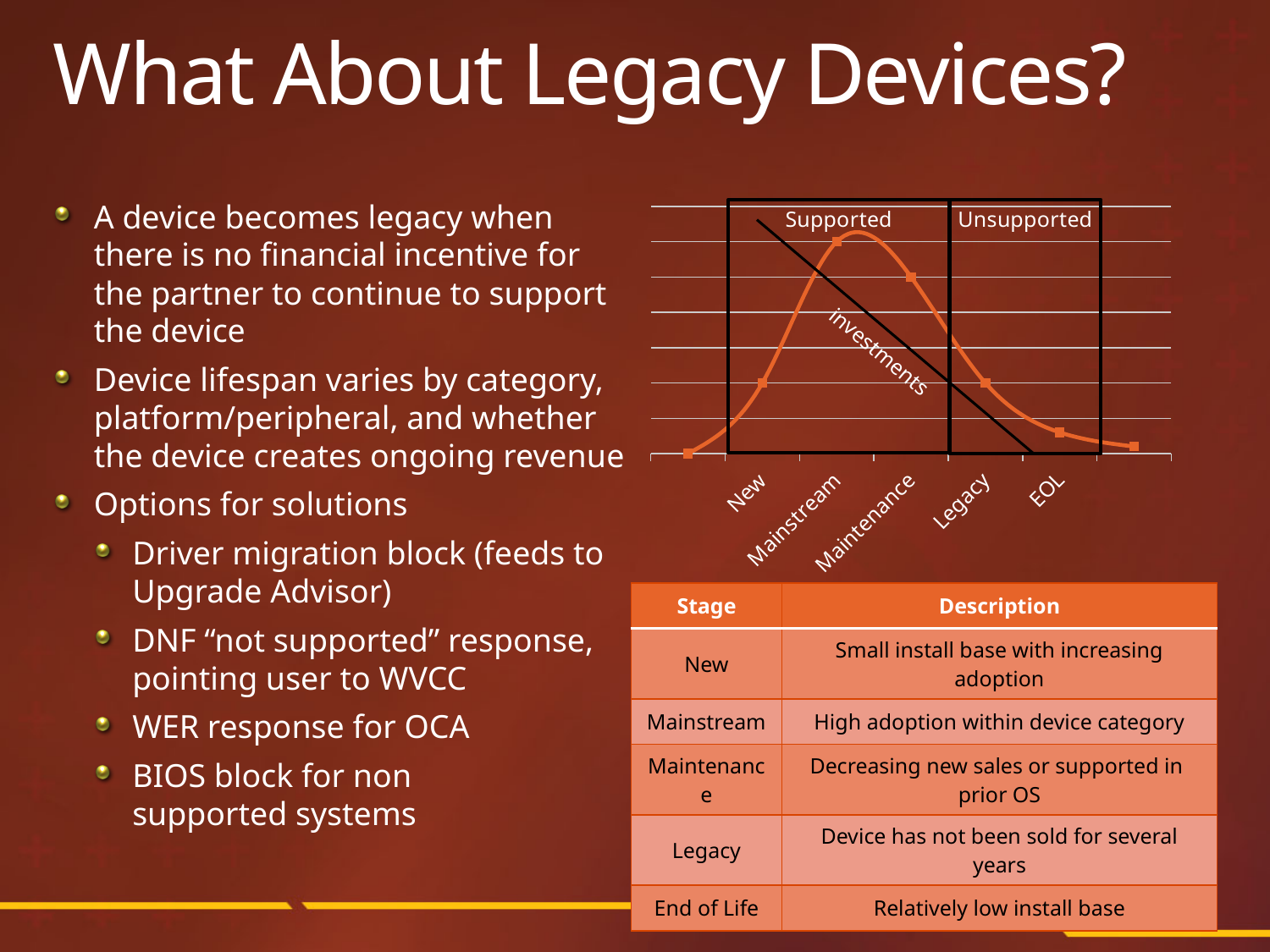
Does the straight diagonal line labelled Investments rise or fall from left to right? fall What label is written along the straight diagonal line in the chart? Investments Which is lower on the curve, Maintenance or Legacy? Legacy How many stage categories are labelled along the x axis of the chart? 5 Which is higher on the curve, Mainstream or EOL? Mainstream Does the curve rise or fall between Legacy and EOL? fall What is the first category on the x axis of the chart? New What kind of chart is shown on the right side of the slide? line chart What is the last category on the x axis of the chart? EOL Does the curve rise or fall between New and Mainstream? rise What are the two region labels shown at the top of the chart? Supported and Unsupported